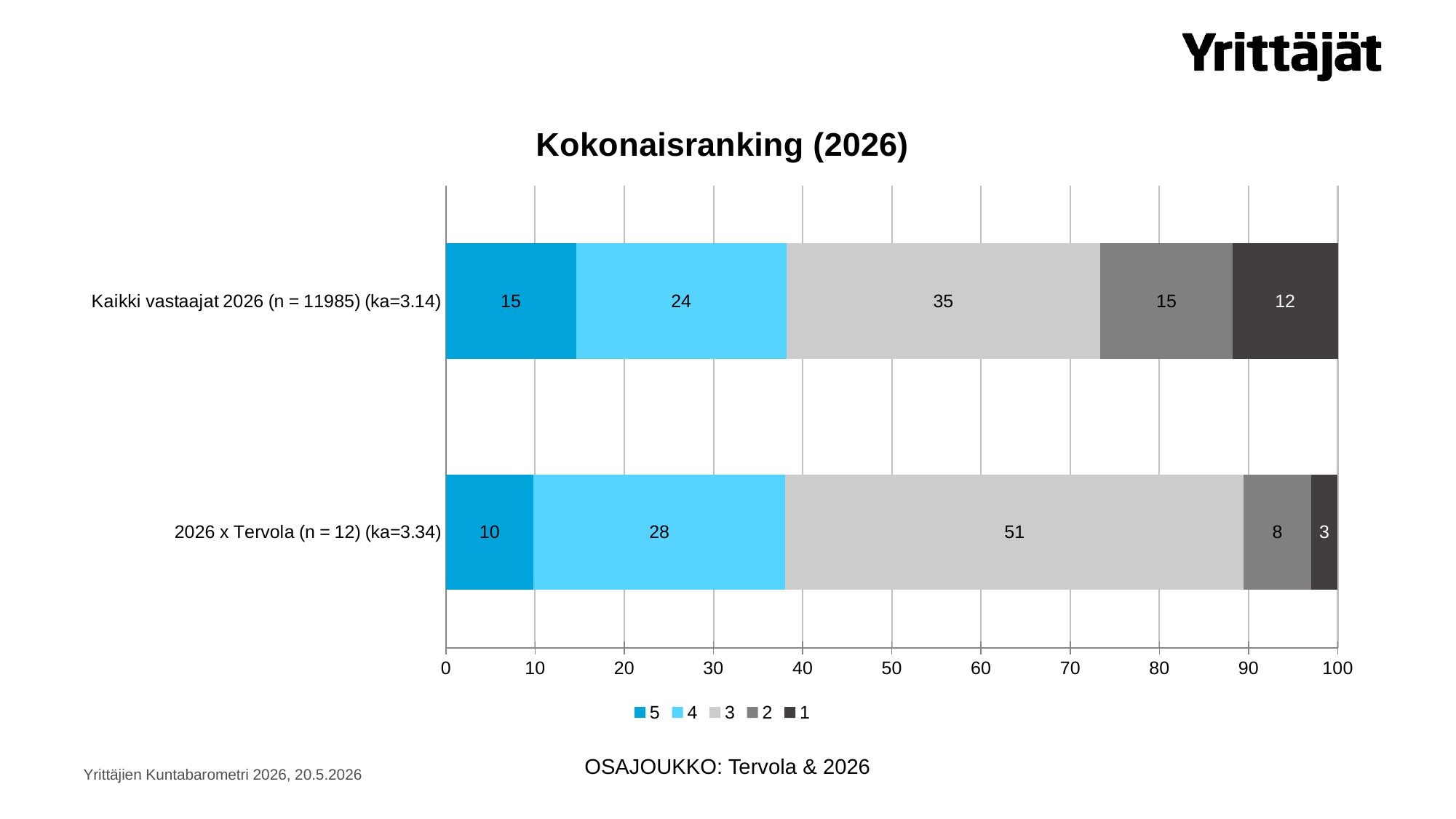
What is the difference between the series 3 values for "2026 x Tervola (n = 12) (ka=3.34)" and "Kaikki vastaajat 2026 (n = 11985) (ka=3.14)"? 16 Which category has the larger value for series 2: "Kaikki vastaajat 2026 (n = 11985) (ka=3.14)" or "2026 x Tervola (n = 12) (ka=3.34)"? Kaikki vastaajat 2026 (n = 11985) (ka=3.14) What is the value of series 1 for "2026 x Tervola (n = 12) (ka=3.34)"? 3 How many series does the legend list? 5 Which series has the lowest value for "2026 x Tervola (n = 12) (ka=3.34)"? 1 Which series has the highest value for "2026 x Tervola (n = 12) (ka=3.34)"? 3 What is the value of series 5 for "2026 x Tervola (n = 12) (ka=3.34)"? 10 What is the value of series 4 for "Kaikki vastaajat 2026 (n = 11985) (ka=3.14)"? 24 What is the title of the chart? Kokonaisranking (2026) How many categories are shown on the chart? 2 What is the value of series 3 for "Kaikki vastaajat 2026 (n = 11985) (ka=3.14)"? 35 What kind of chart is shown on the slide? Stacked bar chart